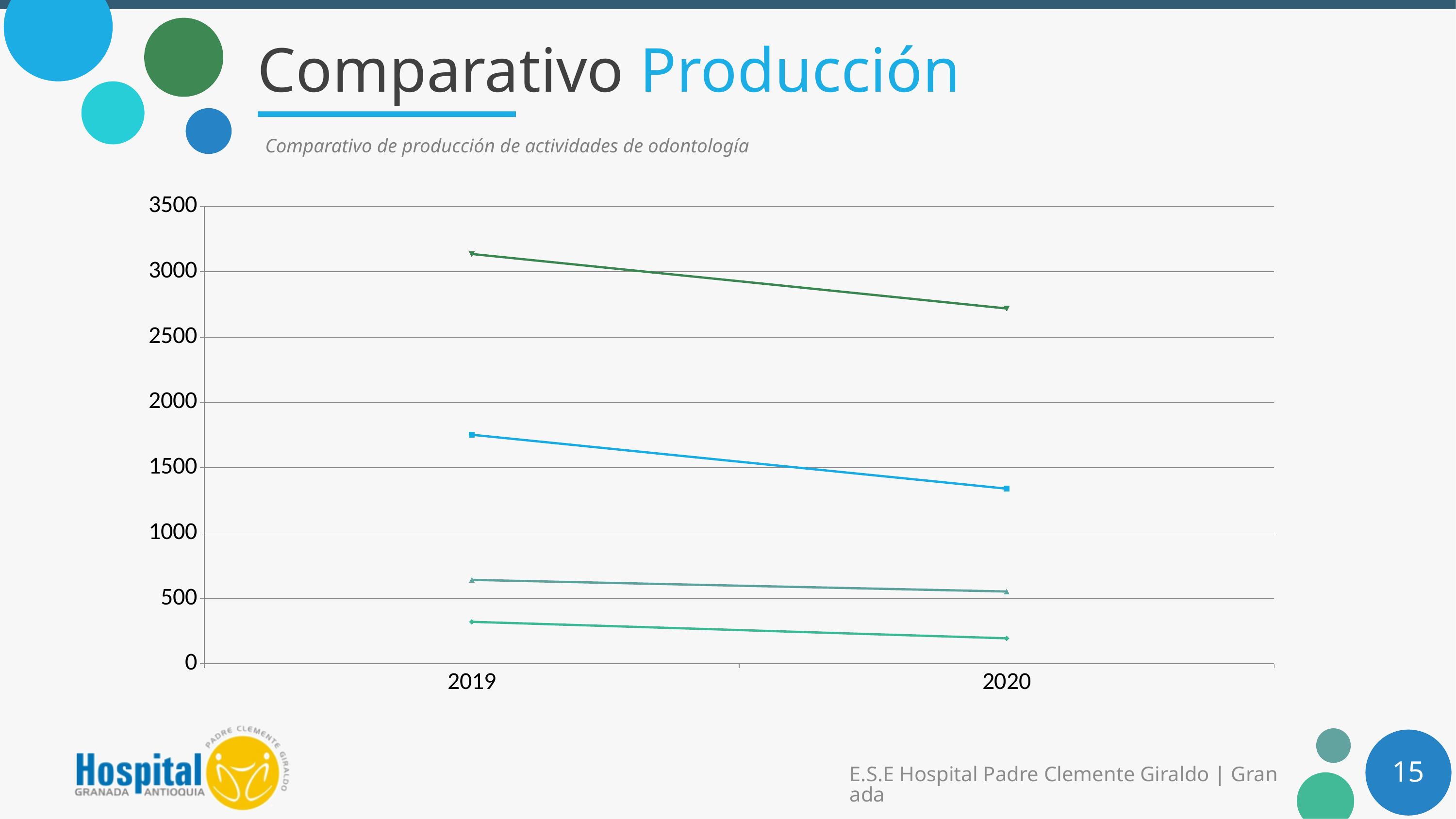
Is the value of the dark green line in 2020 greater or less than 3000? less Is the value of the blue line in 2019 greater or less than 1500? greater Is the value of the dark green line in 2019 greater or less than 3000? greater Does the top (dark green) line rise or fall from 2019 to 2020? fall What is the subtitle shown above the chart? Comparativo de producción de actividades de odontología How many years are shown on the x axis of the chart? 2 Does the blue line rise or fall from 2019 to 2020? fall Does the bottom (light green) line rise or fall from 2019 to 2020? fall What kind of chart is shown on the slide? line chart How many lines are plotted on the chart? 4